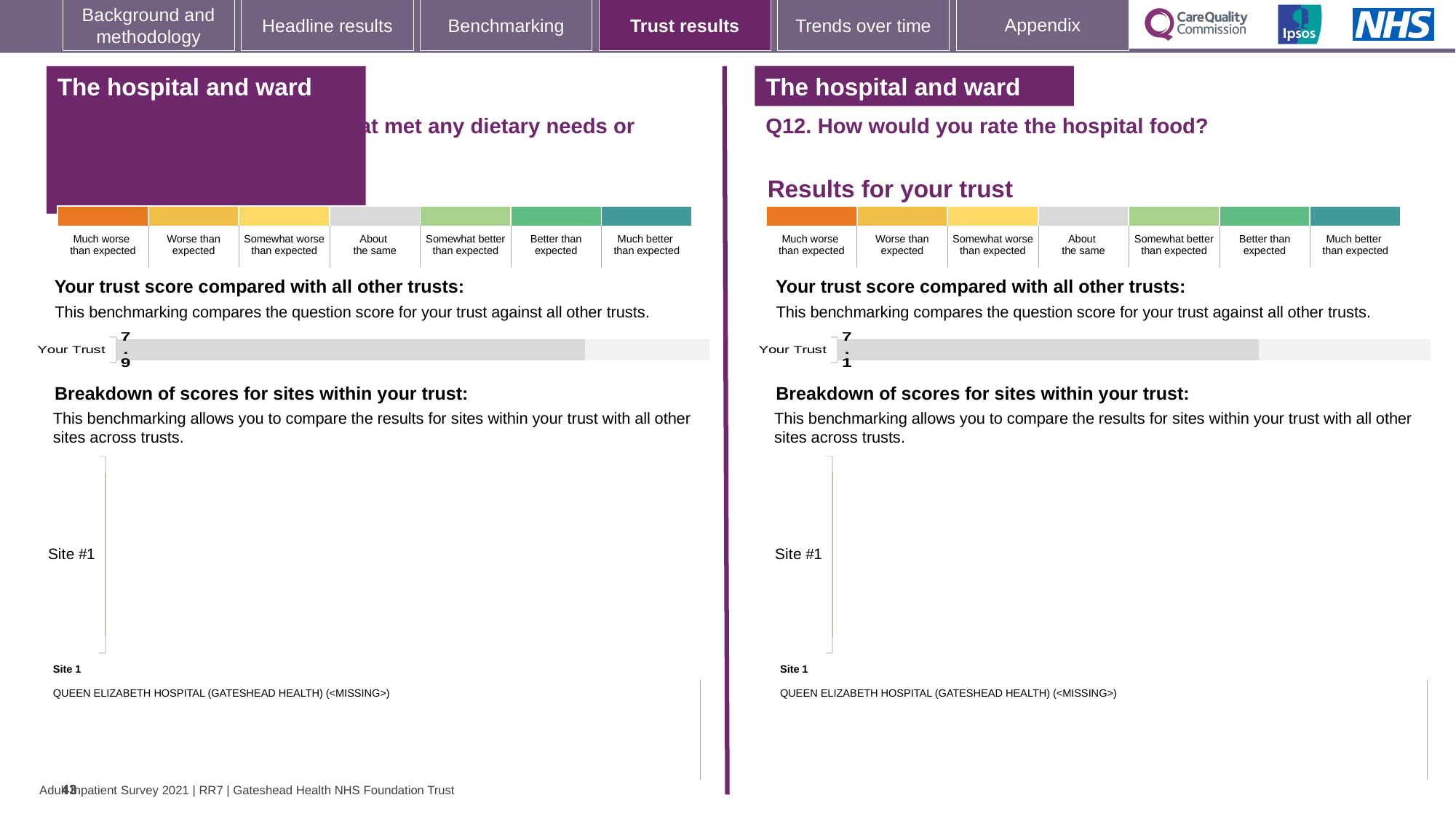
On the right-hand Q12 panel, which site name is listed as Site 1? QUEEN ELIZABETH HOSPITAL (GATESHEAD HEALTH) (<MISSING>) How many rating bands are shown in the colour scale above the right-hand Q12 chart? 7 How many categories are plotted on the left-hand 'Your trust score compared with all other trusts' chart? 1 (Your Trust) What is the difference between the Your Trust score on the left-hand chart (7.9) and the Your Trust score on the right-hand Q12 chart (7.1)? 0.8 How many sites are listed in the right-hand 'Breakdown of scores for sites within your trust' chart? 1 (Site #1) On the right-hand chart for Q12 'How would you rate the hospital food?', what is the score shown for Your Trust? 7.1 On the left-hand 'Your trust score compared with all other trusts' chart, what is the score shown for Your Trust? 7.9 Which is larger: the Your Trust score on the left-hand chart or the Your Trust score on the right-hand Q12 chart? The left-hand chart (7.9) What kind of chart is used to show the Your Trust score on the right-hand Q12 panel? Bar chart